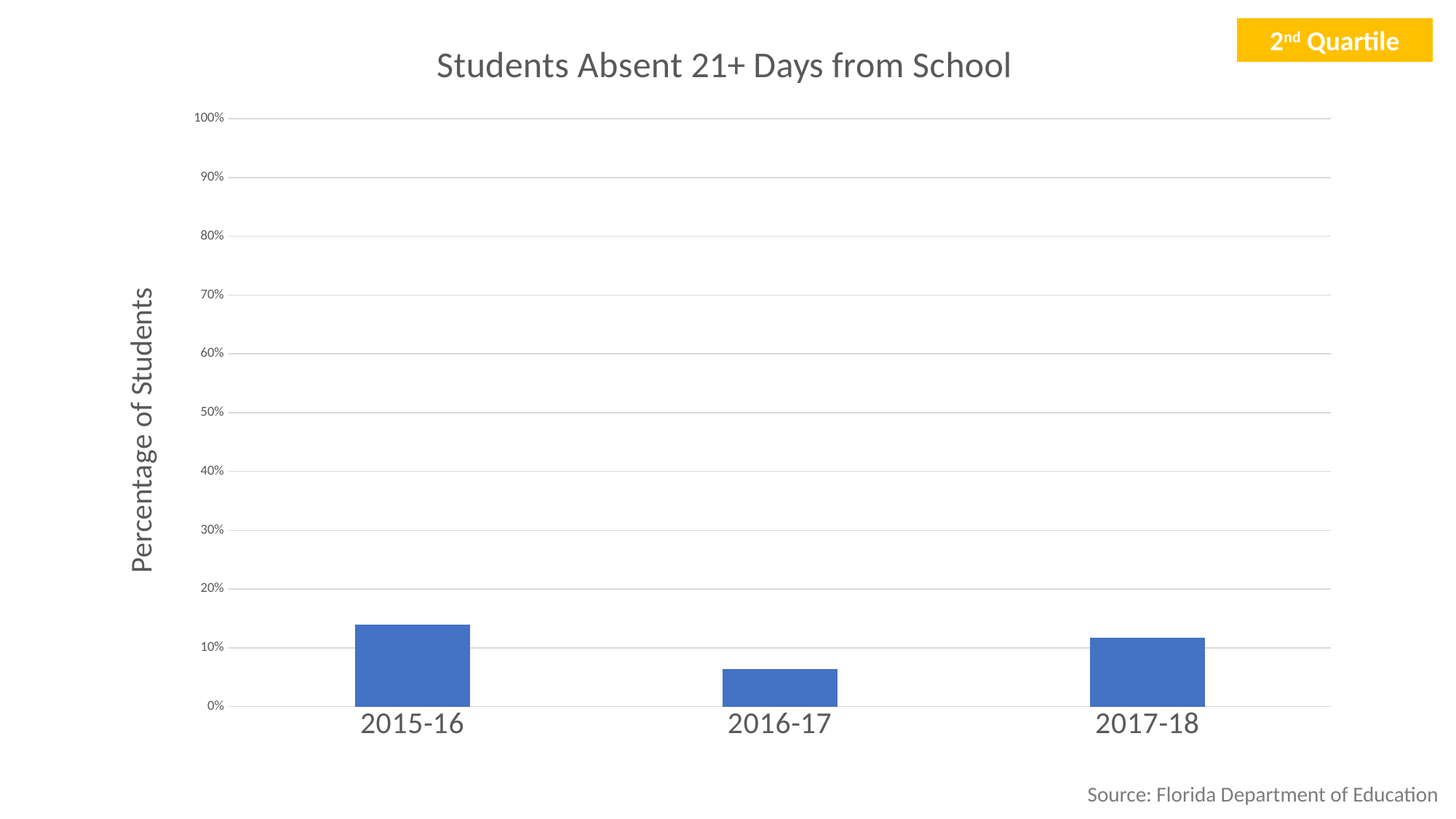
Is the value for 2017-18 greater or less than 20%? less Which is larger, the value for 2015-16 or the value for 2016-17? 2015-16 Is the value for 2016-17 greater or less than 10%? less Which school year has the highest percentage of students absent 21+ days? 2015-16 Which is larger, the value for 2016-17 or the value for 2017-18? 2017-18 What kind of chart is shown on the slide? bar chart Is the value for 2015-16 greater or less than 10%? greater Which school year has the lowest percentage of students absent 21+ days? 2016-17 What is the title of the chart? Students Absent 21+ Days from School Does the value rise or fall from 2015-16 to 2016-17? fall What is the label on the y axis of the chart? Percentage of Students How many school years are shown on the x axis of the chart? 3